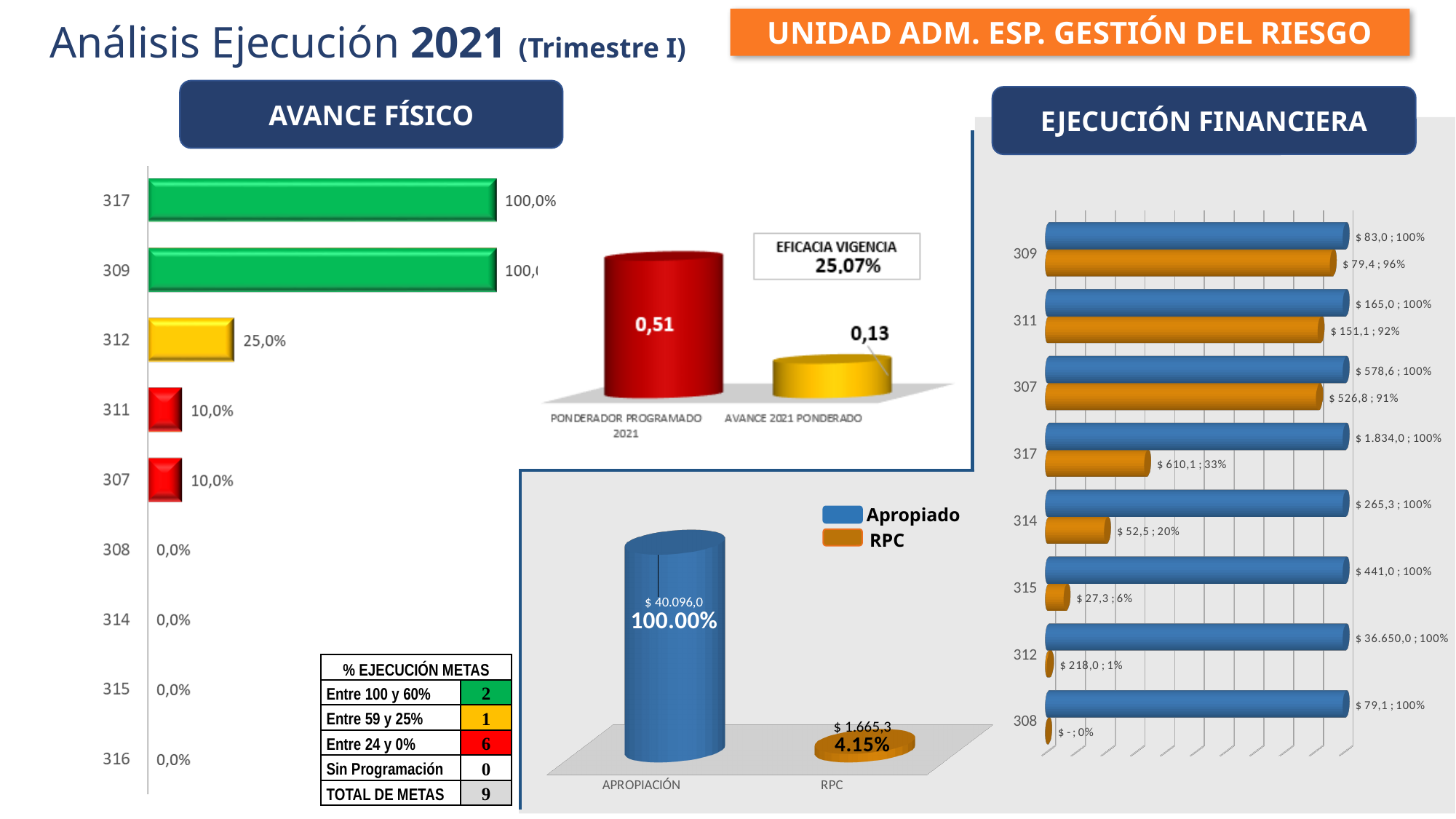
What kind of chart is the EJECUCIÓN FINANCIERA chart? Bar chart In the AVANCE FÍSICO bar chart, what is the difference between the values for 317 and 312? 75,0% In the AVANCE FÍSICO bar chart, how many categories are plotted? 9 In the EJECUCIÓN FINANCIERA chart, what is the RPC value for category 317? $ 610,1 ; 33% In the APROPIACIÓN / RPC chart at the bottom centre, what percentage is shown for APROPIACIÓN? 100.00% In the EJECUCIÓN FINANCIERA chart, how many series does the legend list? 2 In the EFICACIA VIGENCIA chart, what is the value for AVANCE 2021 PONDERADO? 0,13 In the AVANCE FÍSICO bar chart, what is the value for category 312? 25,0% In the APROPIACIÓN / RPC chart at the bottom centre, what is the value shown for RPC? $ 1.665,3 In the EFICACIA VIGENCIA chart, what is the value for PONDERADOR PROGRAMADO 2021? 0,51 In the AVANCE FÍSICO bar chart, which is larger, the value for 312 or the value for 311? 312 In the EJECUCIÓN FINANCIERA chart, which category has the highest Apropiado value? 312